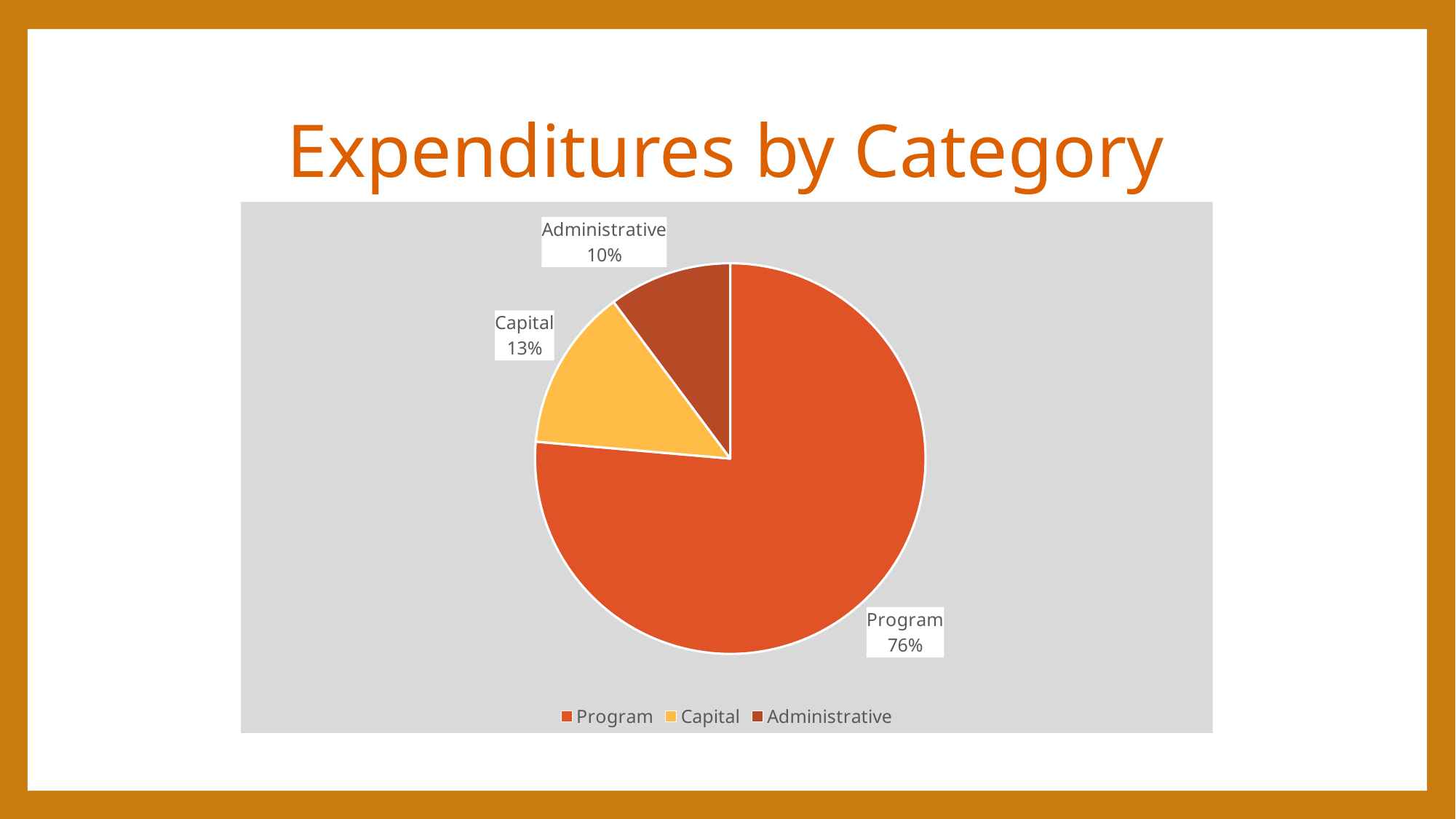
What is the difference in percentage points between the Program and Capital shares? 63 What share of expenditures does the Capital slice represent? 13% Which category has the smallest share of expenditures? Administrative How many categories are shown in the pie chart? 3 What share of expenditures does the Administrative slice represent? 10% What kind of chart is shown on the slide? Pie chart Which category has the largest share of expenditures? Program Which is larger, the Capital share or the Administrative share? Capital What is the difference in percentage points between the Capital and Administrative shares? 3 What is the title of the slide? Expenditures by Category What colour is the Capital slice? Yellow What share of expenditures does the Program slice represent? 76%